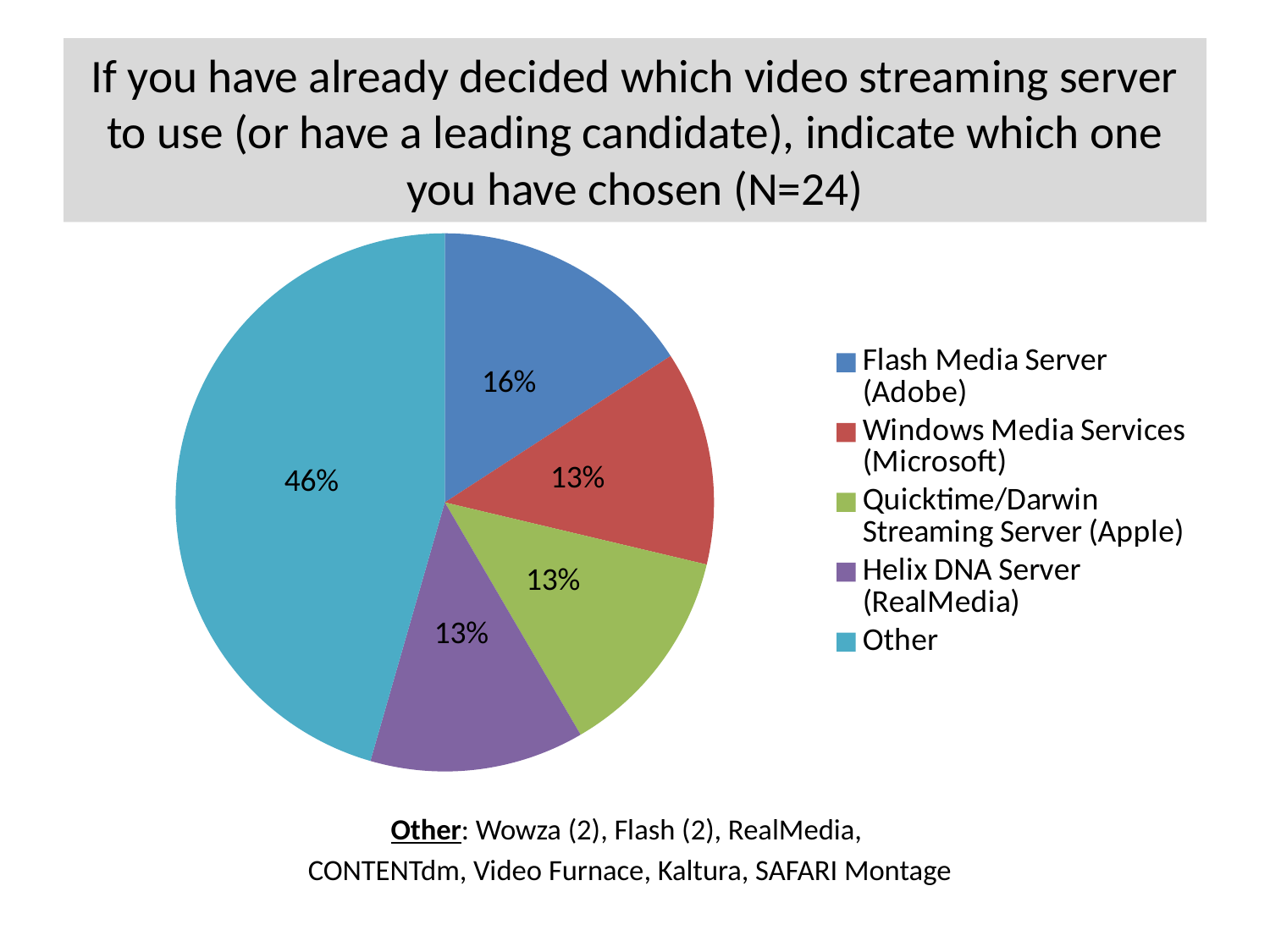
What share of the pie does Helix DNA Server (RealMedia) represent? 13% What colour is the Other slice in the pie chart? teal/light blue What is the difference in percentage points between the Other slice and the Flash Media Server (Adobe) slice? 30 What share of the pie does Windows Media Services (Microsoft) represent? 13% How many entries does the legend list? 5 What share of the pie does Other represent? 46% What is the difference in percentage points between the Flash Media Server (Adobe) slice and the Windows Media Services (Microsoft) slice? 3 Which category has the largest slice of the pie? Other How many slices does the pie chart have? 5 Which slice is larger, Flash Media Server (Adobe) or Quicktime/Darwin Streaming Server (Apple)? Flash Media Server (Adobe) What type of chart is shown on the slide? pie chart